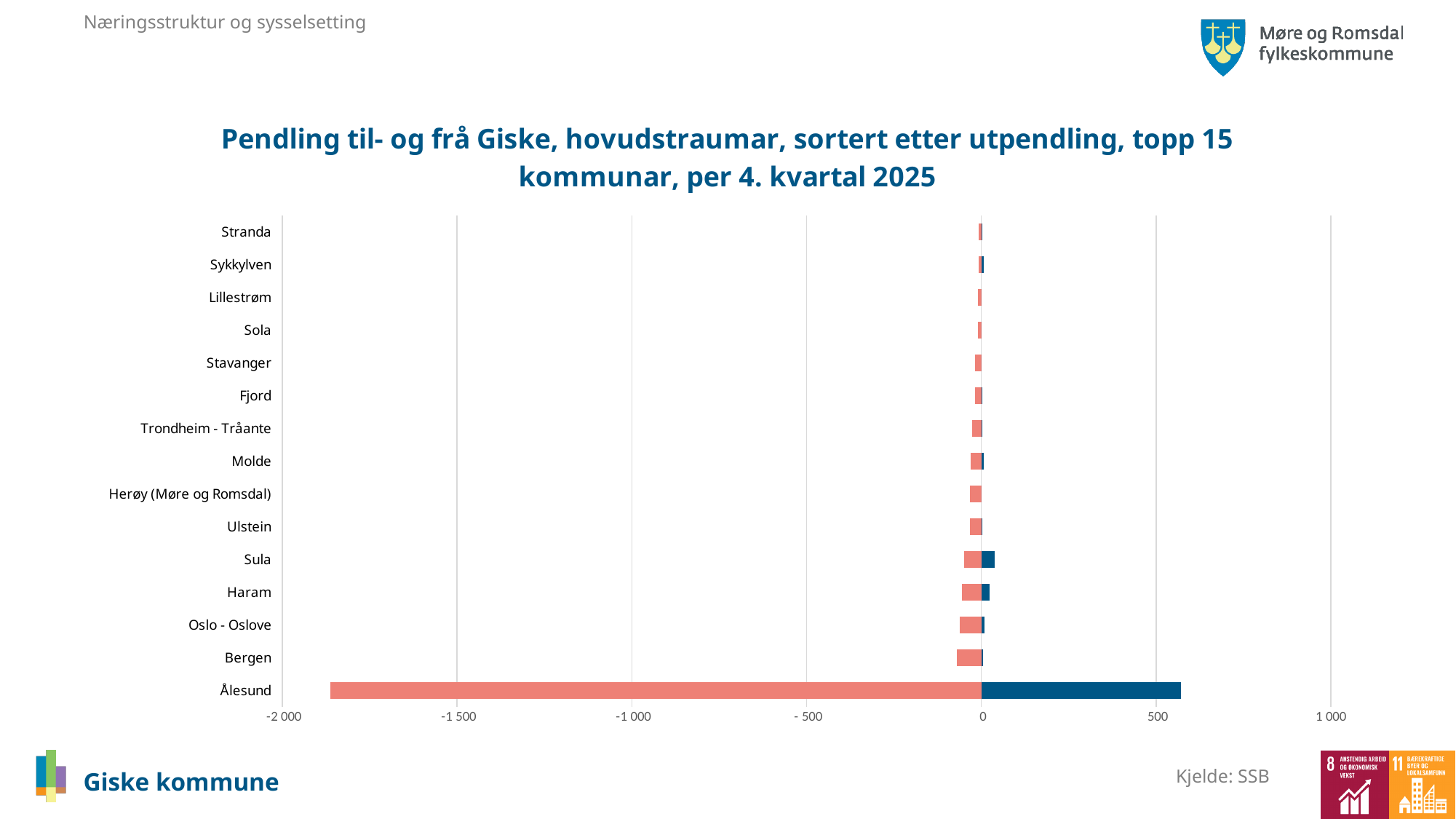
Which municipality has the longest bars in the chart? Ålesund Is the blue bar for Ålesund greater or less than 500? greater Is the red bar for Bergen greater or less than -500 in magnitude (i.e. does it stay between -500 and 0)? less Which municipality is listed at the top of the chart? Stranda Which has the longer blue bar, Sula or Haram? Sula How many municipalities (categories) are listed on the vertical axis of the chart? 15 Which has the longer red bar, Bergen or Stranda? Bergen What is the source cited for the chart data? SSB What type of chart is shown on the slide? bar chart Do the red bars get longer or shorter moving down the list from Stranda to Ålesund? longer Which has the longer red bar, Ålesund or Oslo - Oslove? Ålesund Does the red bar for Ålesund extend beyond -1 500 on the axis? yes